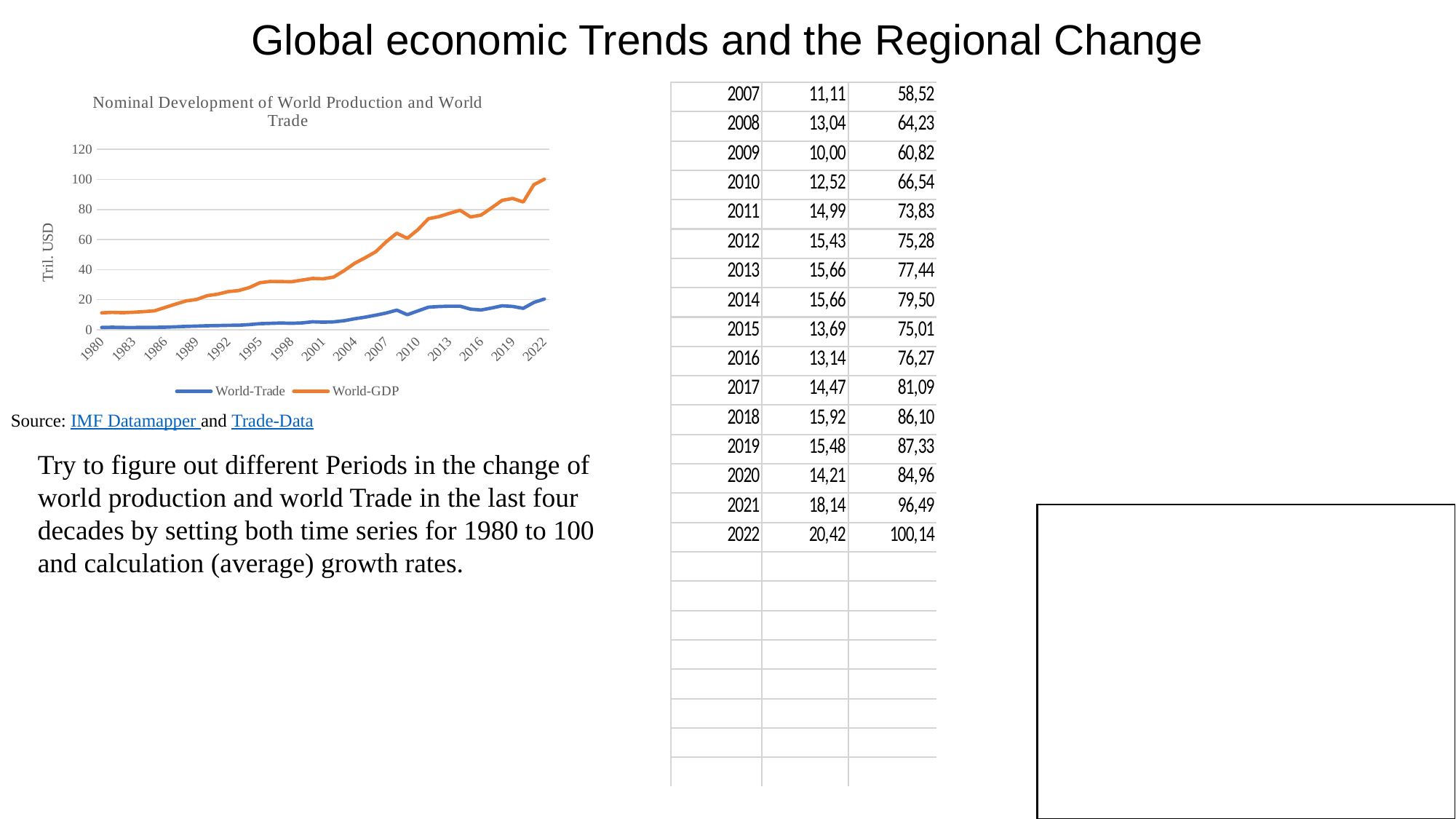
Does the World-GDP line generally rise or fall from 1980 to 2022? rise Is the value for World-GDP in 1980 greater or less than 20? less How many series does the chart's legend list? 2 Is the value for World-Trade in 2022 greater or less than 40? less Is the value for World-GDP in 2007 greater or less than 40? greater What are the two series named in the chart's legend? World-Trade and World-GDP What is the label on the chart's vertical axis? Tril. USD What kind of chart is shown on the slide? line chart How many year labels are shown on the chart's x axis? 15 Which series stays higher than the other across the whole period shown? World-GDP In 2022, which series has the larger value, World-Trade or World-GDP? World-GDP